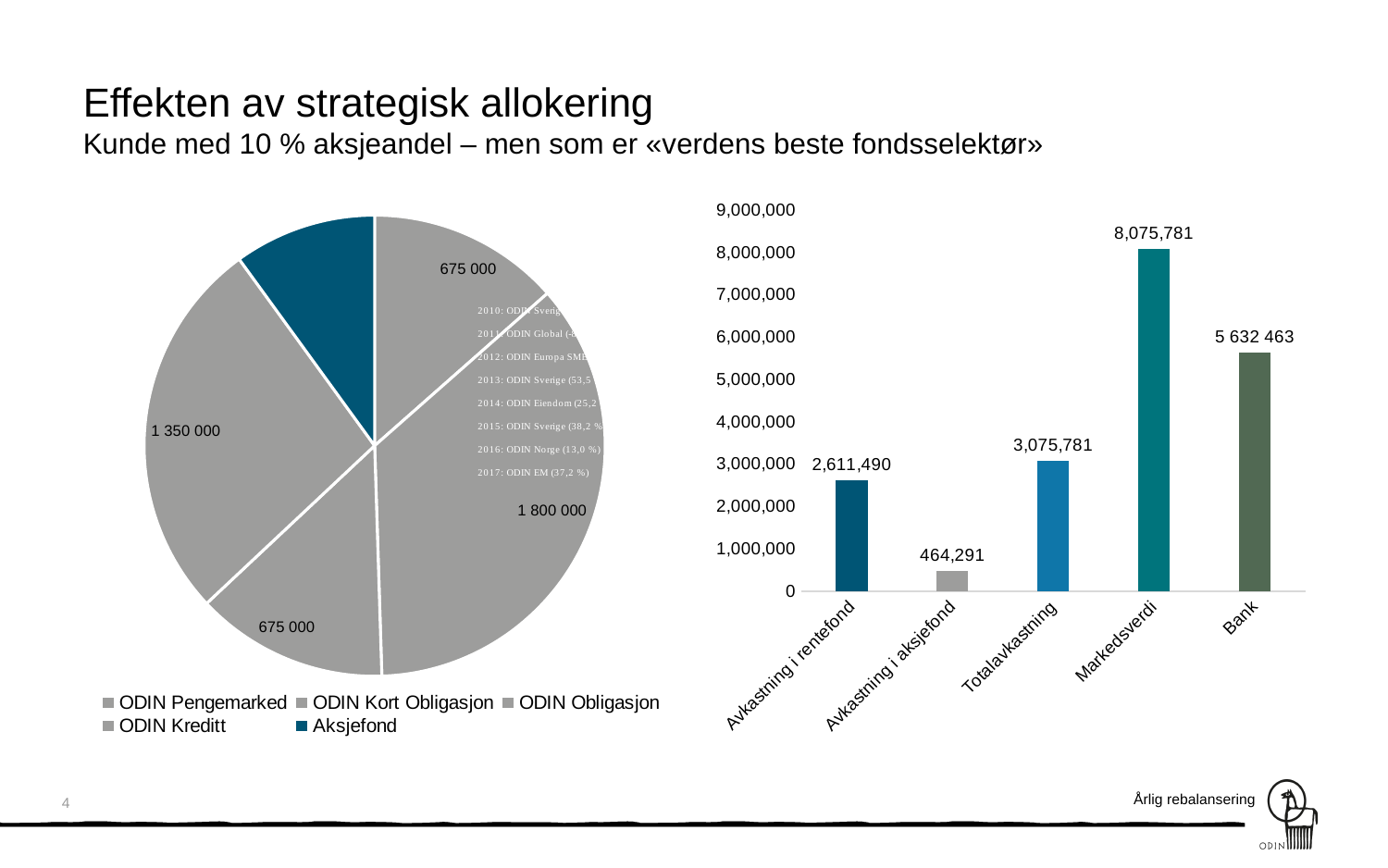
In the bar chart on the right, what is the value for Totalavkastning? 3,075,781 In the bar chart on the right, which is larger: Avkastning i rentefond or Totalavkastning? Totalavkastning In the bar chart on the right, what is the value for Bank? 5 632 463 In the bar chart on the right, what is the difference between Markedsverdi and Bank? 2,443,318 How many entries does the legend of the pie chart on the left list? 5 In the bar chart on the right, which category has the lowest value? Avkastning i aksjefond In the bar chart on the right, which category has the highest value? Markedsverdi In the bar chart on the right, what is the value for Markedsverdi? 8,075,781 What kind of chart is the chart on the left of the slide? Pie chart In the bar chart on the right, what is the difference between Totalavkastning and Avkastning i rentefond? 464,291 In the bar chart on the right, what is the value for Avkastning i aksjefond? 464,291 In the bar chart on the right, how many categories are shown on the x axis? 5